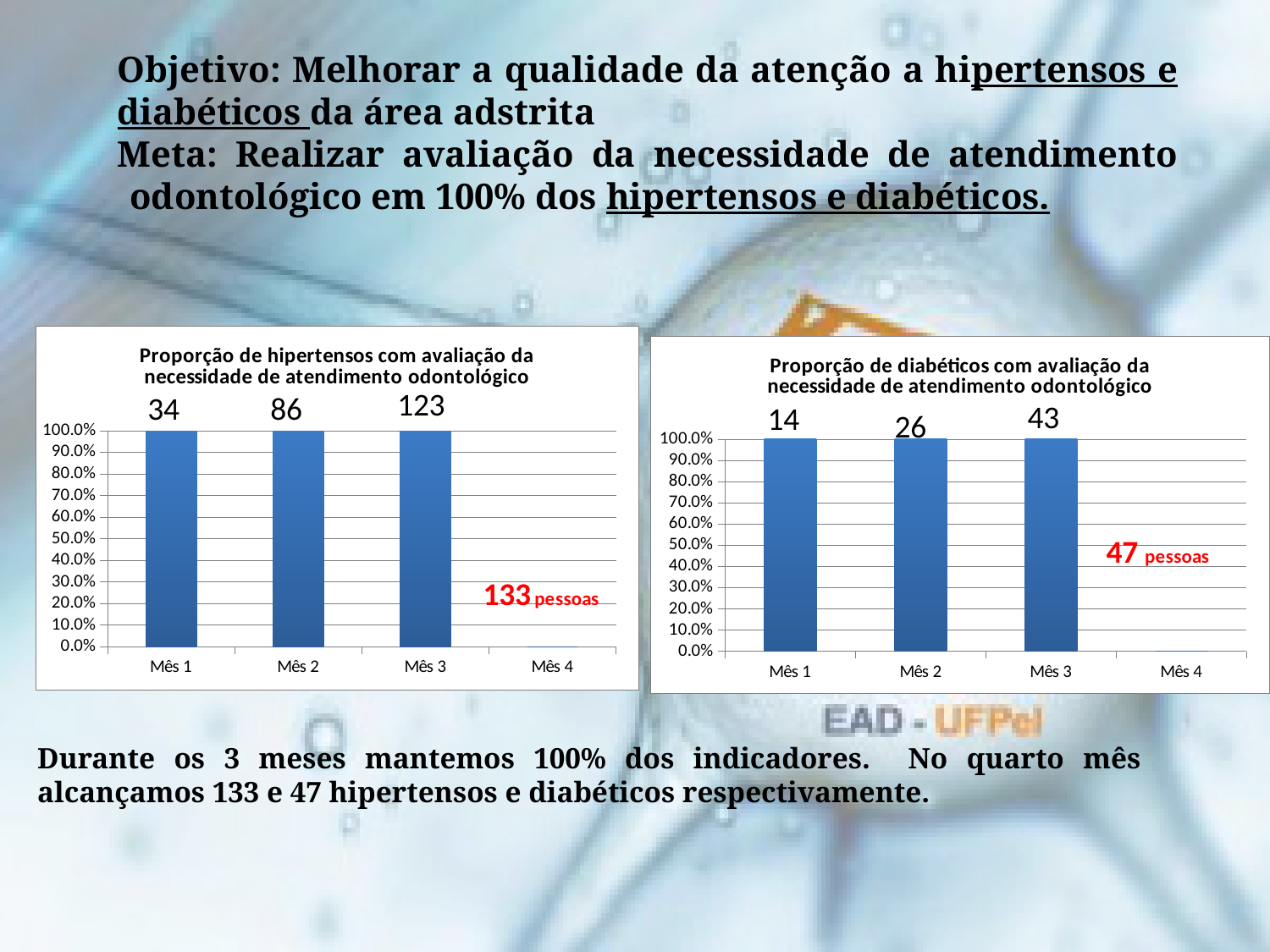
In the chart titled 'Proporção de hipertensos com avaliação da necessidade de atendimento odontológico', what number is printed above the Mês 2 bar? 86 In the chart titled 'Proporção de diabéticos com avaliação da necessidade de atendimento odontológico', what number is printed above the Mês 1 bar? 14 In the right chart (diabéticos), what is the difference between the numbers printed above the Mês 3 and Mês 2 bars? 17 In the chart titled 'Proporção de hipertensos com avaliação da necessidade de atendimento odontológico', what number is printed above the Mês 3 bar? 123 In the left chart (hipertensos), what is the difference between the numbers printed above the Mês 3 and Mês 1 bars? 89 In the left chart (hipertensos), what percentage on the y axis does the Mês 1 bar reach? 100.0% How many categories are shown on the x axis of the left chart (hipertensos)? 4 In the left chart (hipertensos), is the value for Mês 2 greater or less than 50.0%? greater In the right chart (diabéticos), what percentage on the y axis does the Mês 2 bar reach? 100.0% What kind of chart is the right chart (diabéticos)? bar chart In the right chart (diabéticos), which bar has the larger number printed above it, Mês 1 or Mês 3? Mês 3 In the chart titled 'Proporção de diabéticos com avaliação da necessidade de atendimento odontológico', what number is printed above the Mês 3 bar? 43